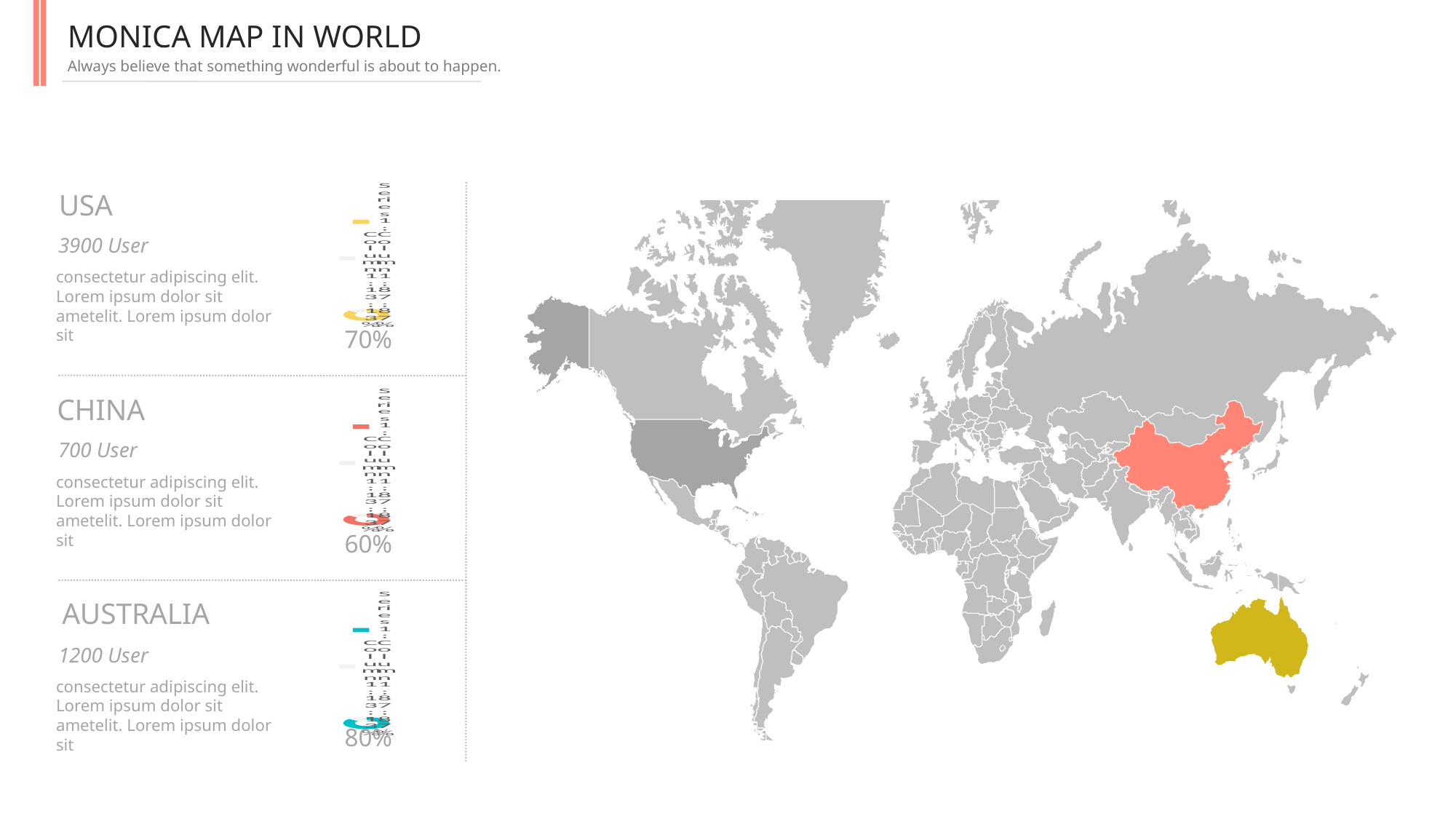
What is the difference between the percentage shown for the AUSTRALIA chart and the CHINA chart? 20% What percentage is shown beside the USA chart? 70% Which of the three country charts shows the highest percentage? AUSTRALIA Is the percentage shown for the USA chart larger or smaller than the one for the CHINA chart? larger What kind of chart is shown next to the USA entry? doughnut chart Which of the three country charts shows the lowest percentage? CHINA What colour is the highlighted segment of the CHINA chart? red What percentage is shown beside the AUSTRALIA chart? 80% How many small doughnut charts are on the slide? 3 What colour is the highlighted segment of the AUSTRALIA chart? teal What percentage is shown beside the CHINA chart? 60%